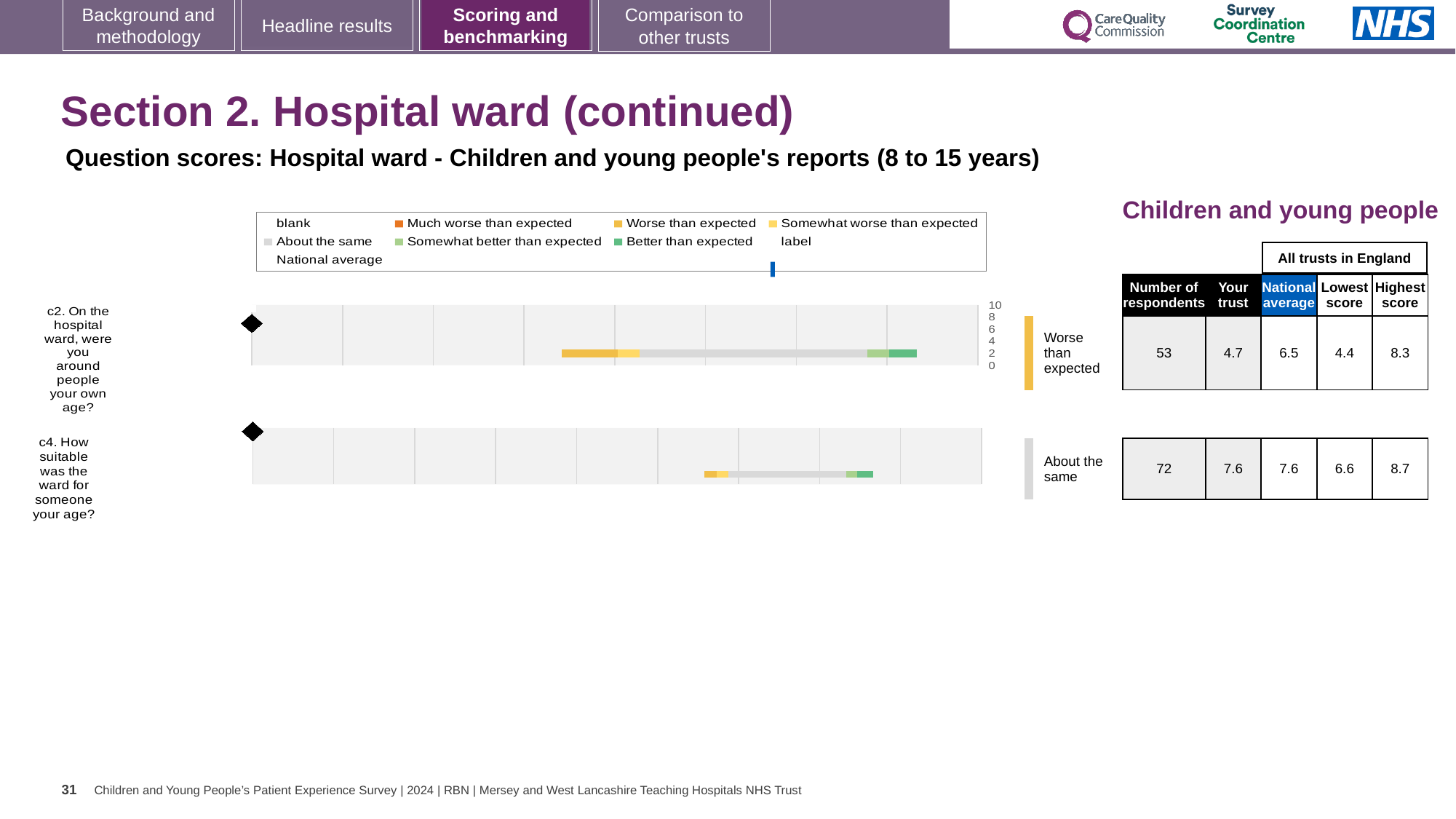
What colour represents 'Better than expected' in the legend? Green What is the 'Your trust' score for c4 (How suitable was the ward for someone your age?)? 7.6 What is the difference between the 'Your trust' scores for c4 and c2? 2.9 What kind of chart is used to show the question scores for c2 and c4? Bar chart What is the 'Your trust' score for c2 (On the hospital ward, were you around people your own age?)? 4.7 What benchmark category is shown for c4? About the same What benchmark category is shown for c2? Worse than expected Which question has the higher 'Your trust' score, c2 or c4? c4 What is the national average score for c2? 6.5 How many respondents answered c4? 72 What is the highest score among all trusts in England for c2? 8.3 How many questions (rows) are plotted on the chart? 2